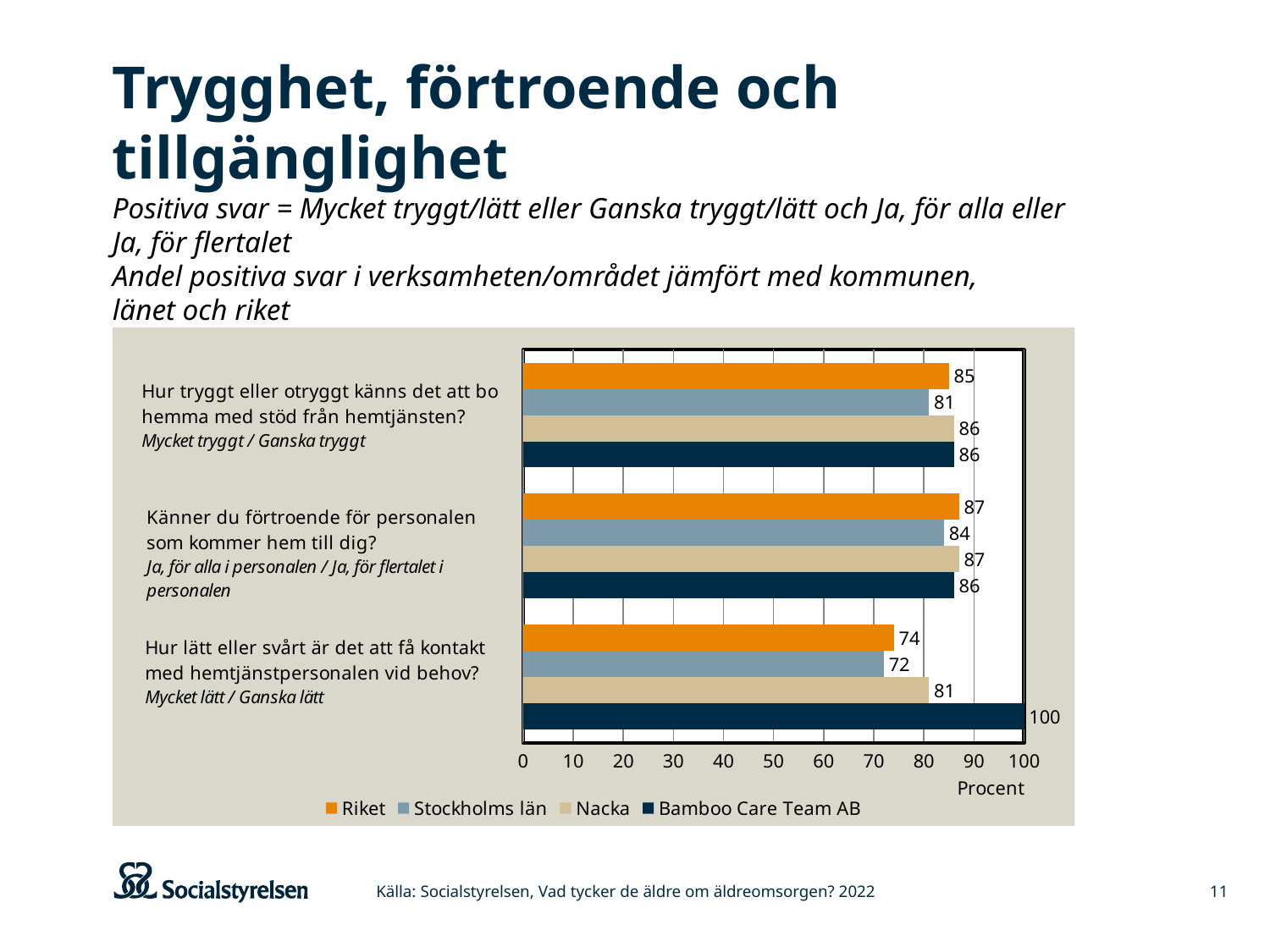
For the question 'Känner du förtroende för personalen som kommer hem till dig?', which is larger: Riket or Stockholms län? Riket Which series has the lowest value for the question 'Hur lätt eller svårt är det att få kontakt med hemtjänstpersonalen vid behov?' Stockholms län What is the value for Nacka for the question 'Hur lätt eller svårt är det att få kontakt med hemtjänstpersonalen vid behov?' 81 What is the value for Bamboo Care Team AB for the question 'Hur lätt eller svårt är det att få kontakt med hemtjänstpersonalen vid behov?' 100 What is the value for Riket for the question 'Känner du förtroende för personalen som kommer hem till dig?' 87 What kind of chart is shown on the slide? bar chart Which series has the highest value for the question 'Hur lätt eller svårt är det att få kontakt med hemtjänstpersonalen vid behov?' Bamboo Care Team AB How many question categories are plotted on the chart? 3 What is the difference between Bamboo Care Team AB and Riket for the question 'Hur lätt eller svårt är det att få kontakt med hemtjänstpersonalen vid behov?' 26 What is the label of the horizontal axis? Procent What is the value for Stockholms län for the question 'Hur tryggt eller otryggt känns det att bo hemma med stöd från hemtjänsten?' 81 How many series does the legend list? 4